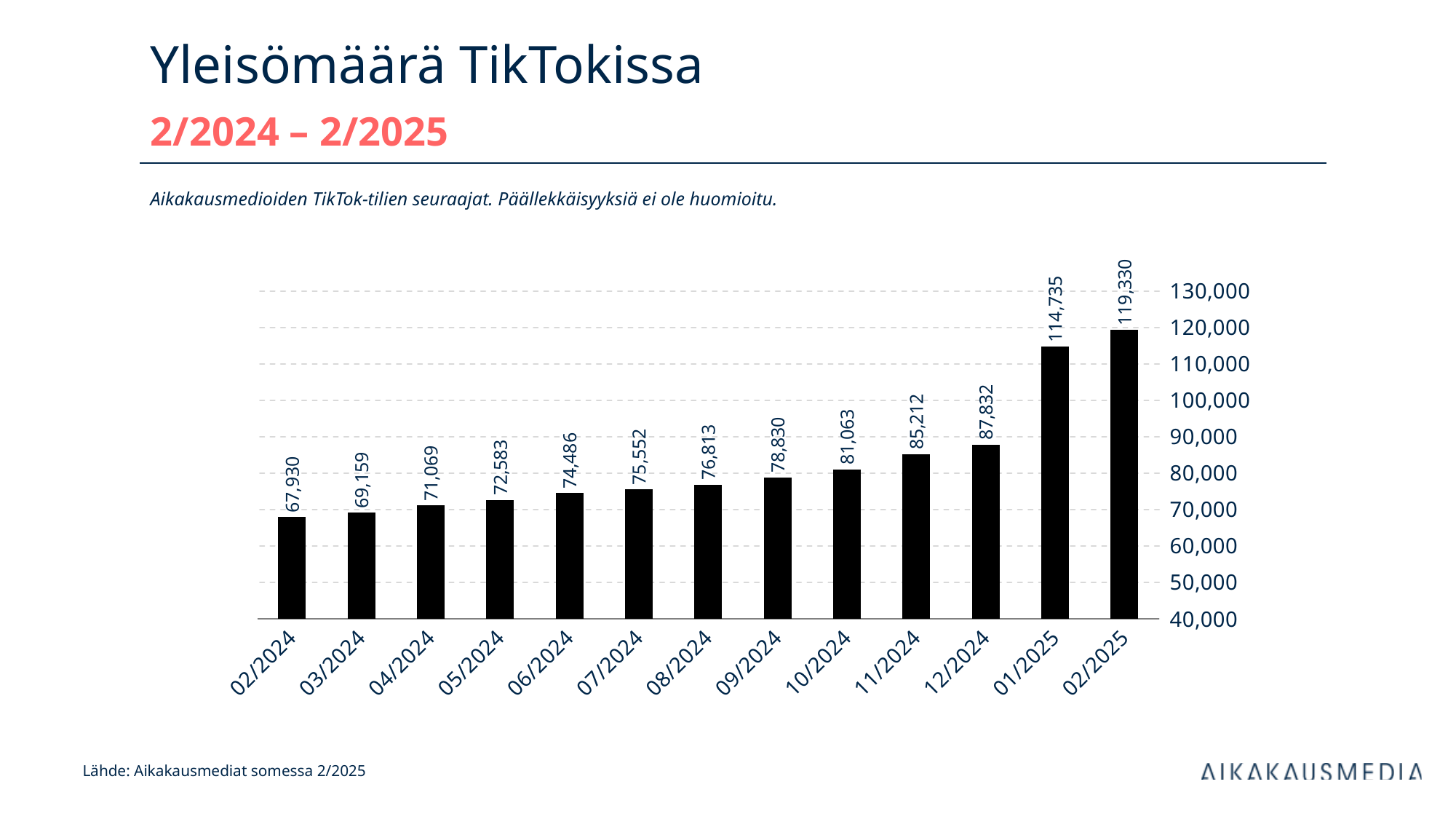
Is the value for 12/2024 greater or less than 90,000? less Which month has the lowest value? 02/2024 Which month has the highest value? 02/2025 Which is larger, the value for 11/2024 or the value for 10/2024? 11/2024 What is the difference between the values for 02/2025 and 01/2025? 4,595 What is the value for 08/2024? 76,813 What kind of chart is shown on the slide? bar chart How many months are shown on the x axis? 13 Do the values rise or fall from 02/2024 to 02/2025? rise What is the value for 01/2025? 114,735 What is the difference between the values for 12/2024 and 02/2024? 19,902 What is the value for 02/2024? 67,930